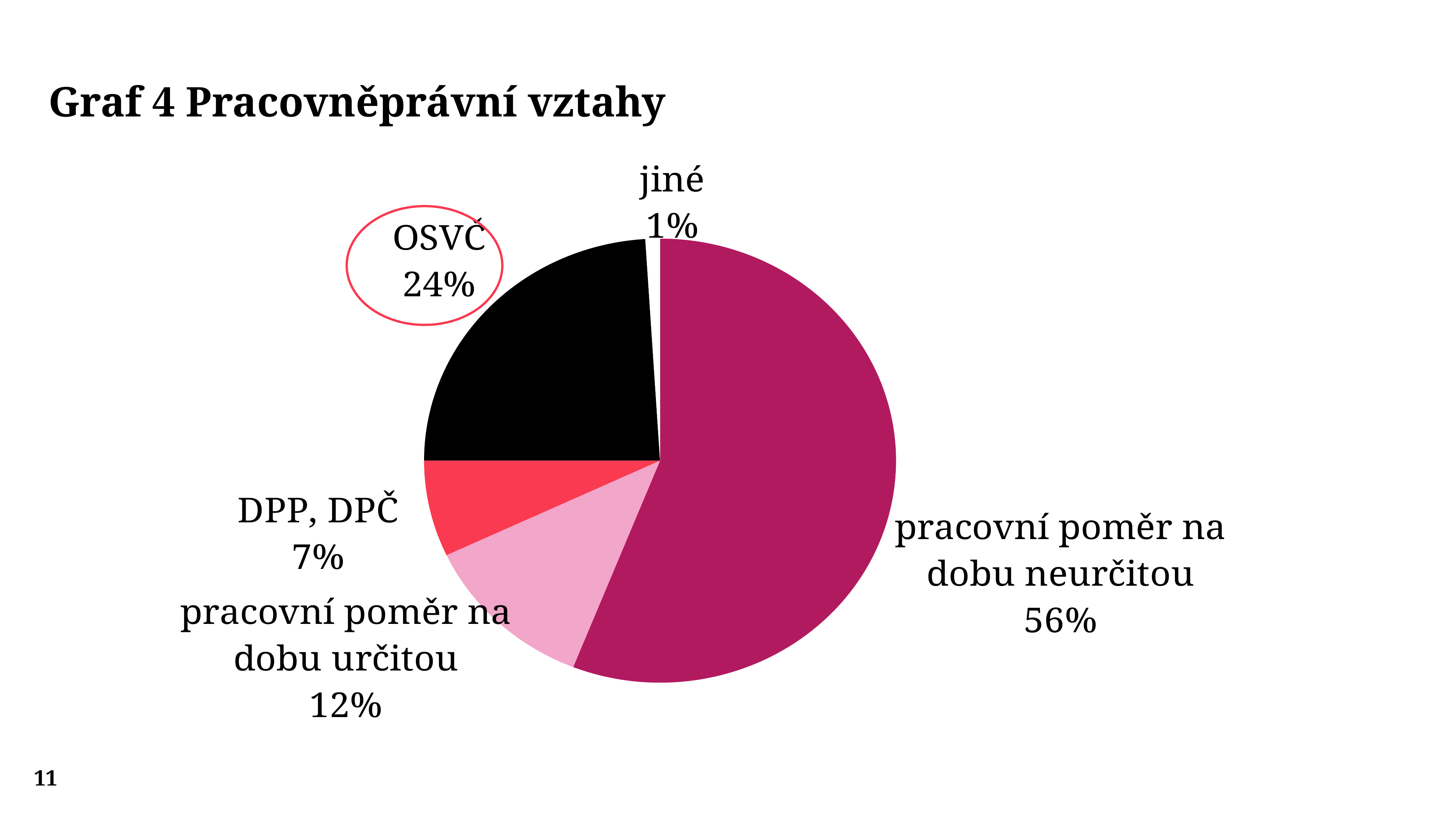
What is the share for 'pracovní poměr na dobu neurčitou'? 56% What is the share for 'DPP, DPČ'? 7% Which category has the smallest slice of the pie? jiné What is the share for 'jiné'? 1% What is the difference between the shares of 'pracovní poměr na dobu neurčitou' and 'OSVČ'? 32% What is the share for 'pracovní poměr na dobu určitou'? 12% Which category has the largest slice of the pie? pracovní poměr na dobu neurčitou What is the title of the chart? Graf 4 Pracovněprávní vztahy What is the share for 'OSVČ'? 24% Which is larger, the share for 'pracovní poměr na dobu určitou' or the share for 'DPP, DPČ'? pracovní poměr na dobu určitou How many slices does the pie chart have? 5 What kind of chart is shown on the slide? pie chart